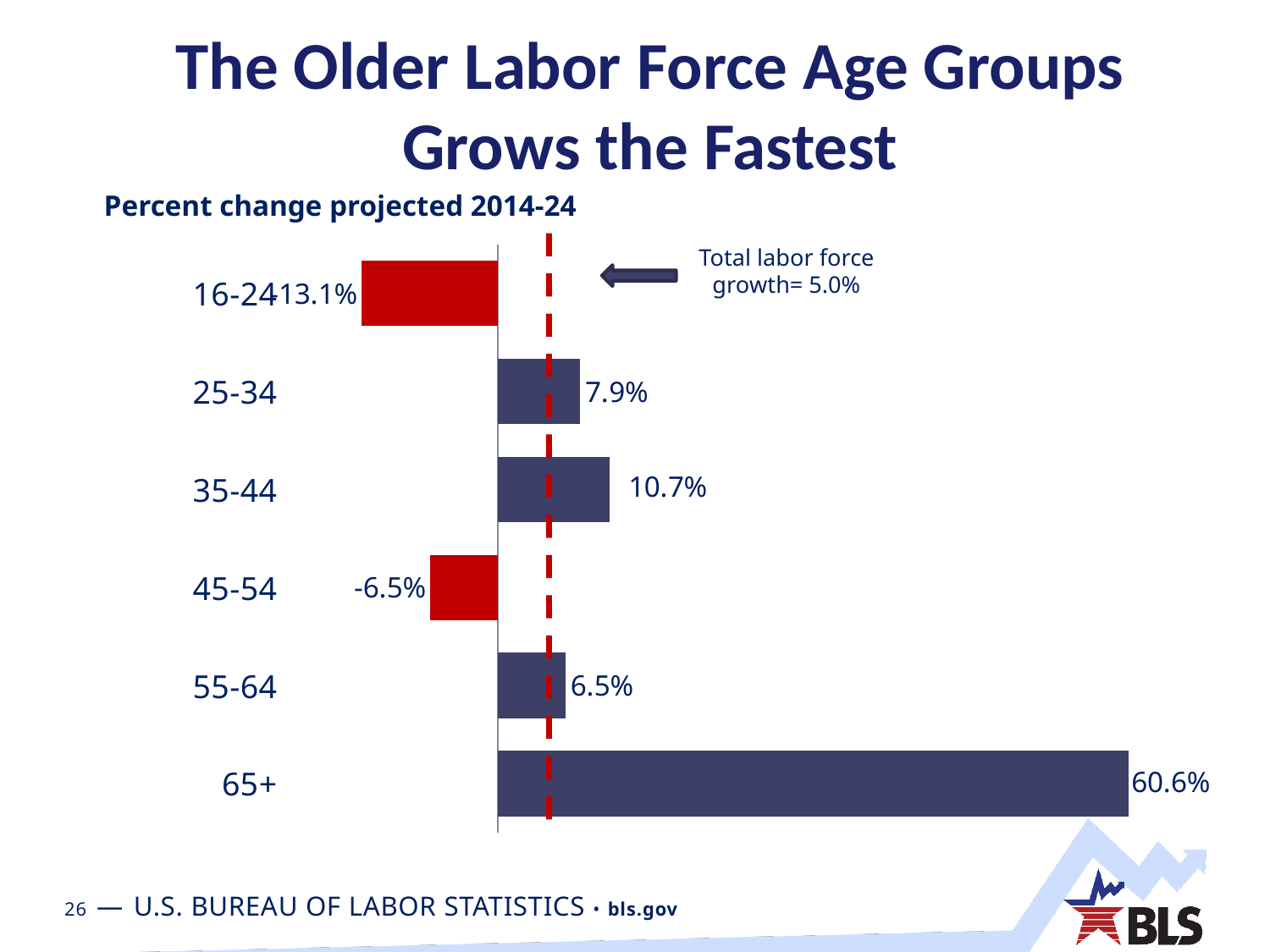
What is the projected percent change for the 45-54 age group? -6.5% What is the difference in projected percent change between the 35-44 and 25-34 age groups? 2.8 percentage points Which has a larger projected percent change, the 25-34 or the 55-64 age group? 25-34 What kind of chart is shown on the slide? bar chart What is the projected percent change for the 35-44 age group? 10.7% What is the projected percent change for the 25-34 age group? 7.9% Which age group has the highest projected percent change? 65+ Which age group has the lowest projected percent change? 16-24 What is the projected percent change for the 65+ age group? 60.6% What is the projected percent change for the 55-64 age group? 6.5% What total labor force growth value does the dashed red line represent? 5.0% How many age groups are plotted in the chart? 6